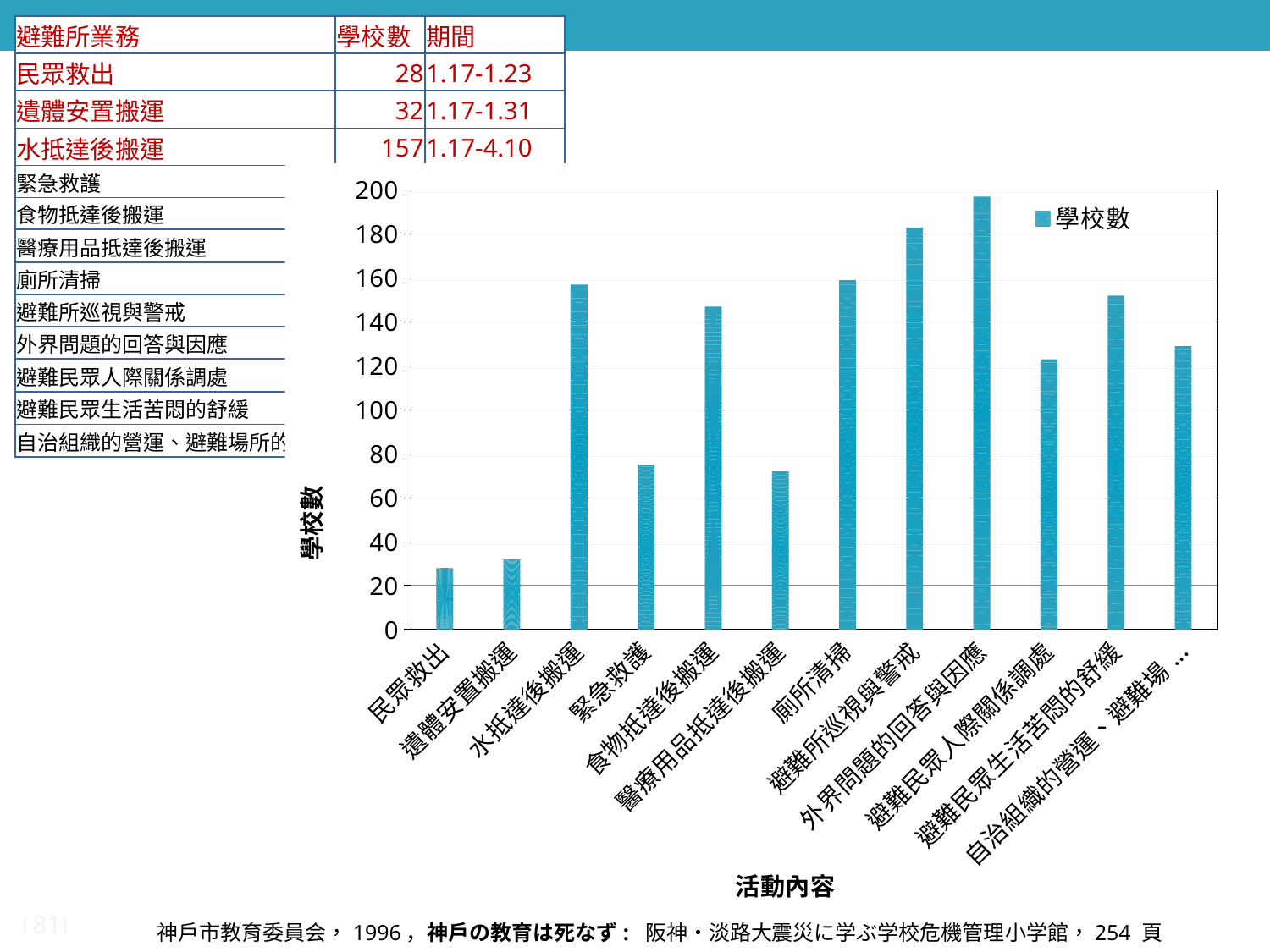
What kind of chart is shown on the slide? bar chart How many series does the legend of the chart list? 1 Which category has the highest value in the bar chart? 外界問題的回答與因應 What is the value for 水抵達後搬運 in the bar chart? 157 What is the difference between the values for 水抵達後搬運 and 民眾救出? 129 Is the value for 廁所清掃 greater or less than 140? greater Which is larger, the value for 遺體安置搬運 or the value for 民眾救出? 遺體安置搬運 How many categories are shown on the x axis of the bar chart? 12 What is the value for 民眾救出 in the bar chart? 28 Which category has the lowest value in the bar chart? 民眾救出 Is the value for 緊急救護 greater or less than 80? less